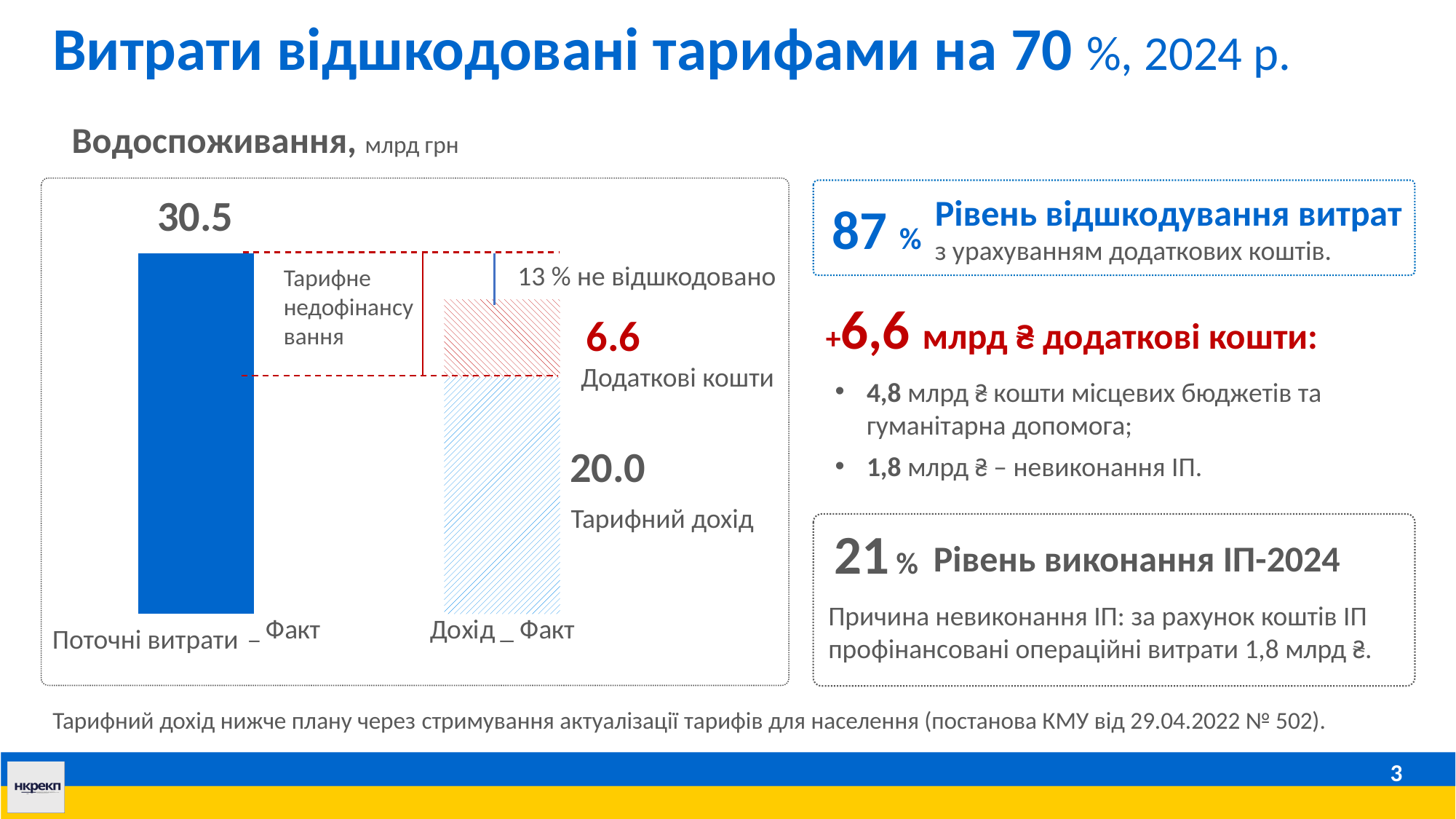
What type of chart is shown on the slide? Bar chart What is the value labelled 'Тарифний дохід' in the 'Дохід – Факт' bar? 20.0 What is the total of the stacked 'Дохід – Факт' bar (Тарифний дохід plus Додаткові кошти)? 26.6 What is the value of the 'Поточні витрати – Факт' bar? 30.5 What is the value labelled 'Додаткові кошти' in the 'Дохід – Факт' bar? 6.6 By how much does 'Поточні витрати – Факт' (30.5) exceed the total of the 'Дохід – Факт' bar (26.6)? 3.9 What percentage is labelled as 'не відшкодовано' on the chart? 13 % In what units are the chart values expressed, according to the chart heading? млрд грн What is the difference between 'Поточні витрати – Факт' (30.5) and 'Тарифний дохід' (20.0)? 10.5 How many bars are shown in the chart? 2 Which is larger: 'Поточні витрати – Факт' or 'Тарифний дохід'? Поточні витрати – Факт Which bar has the highest value in the chart? Поточні витрати – Факт